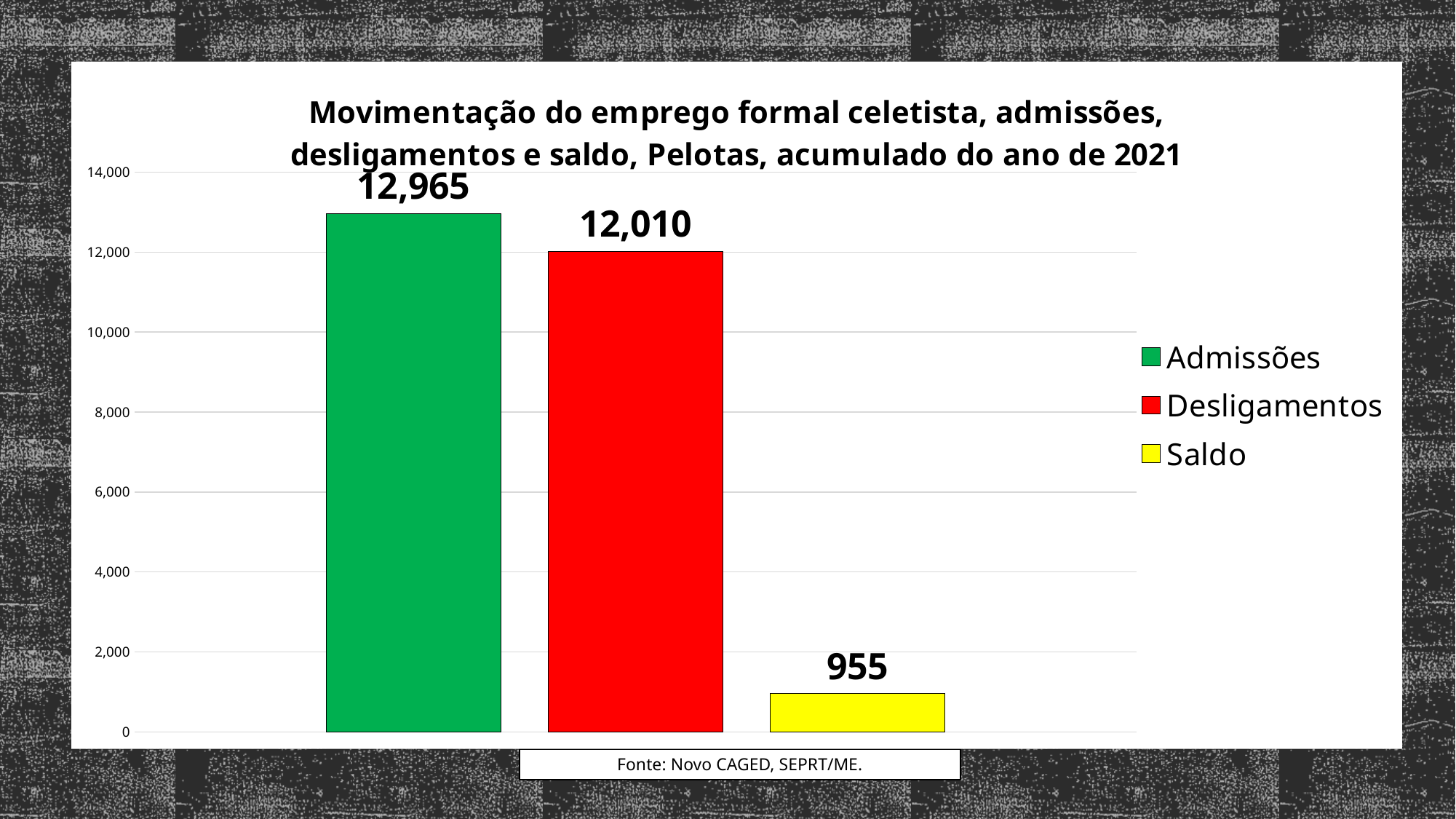
What is the value for Desligamentos? 12,010 What colour is the bar for Saldo? yellow Which category has the lowest value? Saldo How many bars are plotted in the chart? 3 What is the difference between Admissões and Desligamentos? 955 Which is larger, Desligamentos or Saldo? Desligamentos What kind of chart is shown on the slide? bar chart What is the value for Saldo? 955 Which category has the highest value? Admissões Is the value for Saldo greater or less than 2,000? less How many series does the legend list? 3 What is the value for Admissões? 12,965